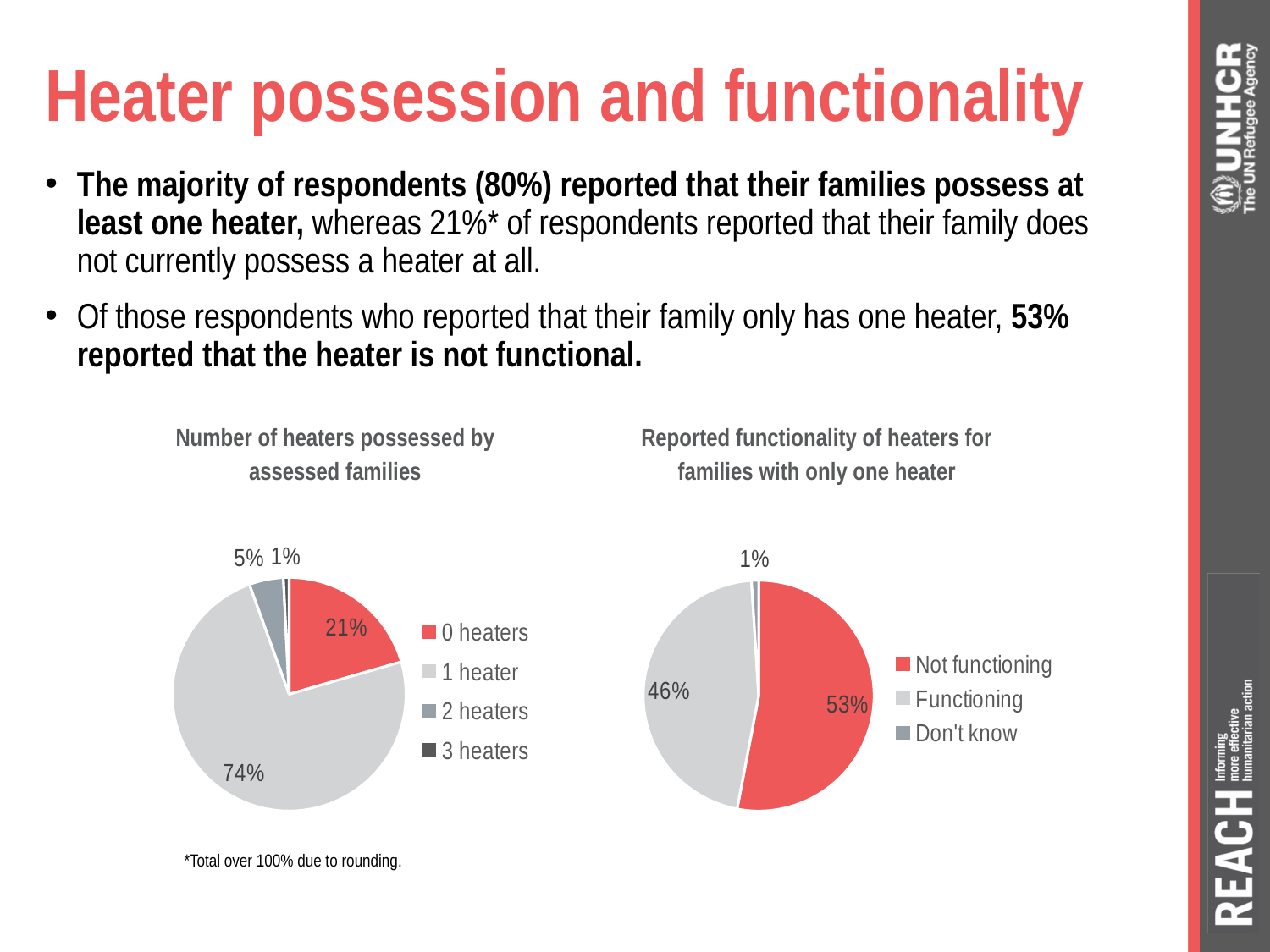
In the chart titled 'Reported functionality of heaters for families with only one heater', what share reported the heater is functioning? 46% In the chart titled 'Reported functionality of heaters for families with only one heater', which is larger: Not functioning or Functioning? Not functioning In the chart titled 'Number of heaters possessed by assessed families', what share of families have 2 heaters? 5% In the chart titled 'Number of heaters possessed by assessed families', what is the difference between the share for 1 heater and the share for 0 heaters? 53% In the chart titled 'Number of heaters possessed by assessed families', which category has the smallest share? 3 heaters What type of chart is used for 'Reported functionality of heaters for families with only one heater'? Pie chart In the chart titled 'Number of heaters possessed by assessed families', what share of families have 0 heaters? 21% In the chart titled 'Number of heaters possessed by assessed families', what share of families have 1 heater? 74% In the chart titled 'Number of heaters possessed by assessed families', how many categories does the legend list? 4 In the chart titled 'Reported functionality of heaters for families with only one heater', what share reported the heater is not functioning? 53% In the chart titled 'Number of heaters possessed by assessed families', which category has the largest share? 1 heater In the chart titled 'Reported functionality of heaters for families with only one heater', which category has the smallest share? Don't know